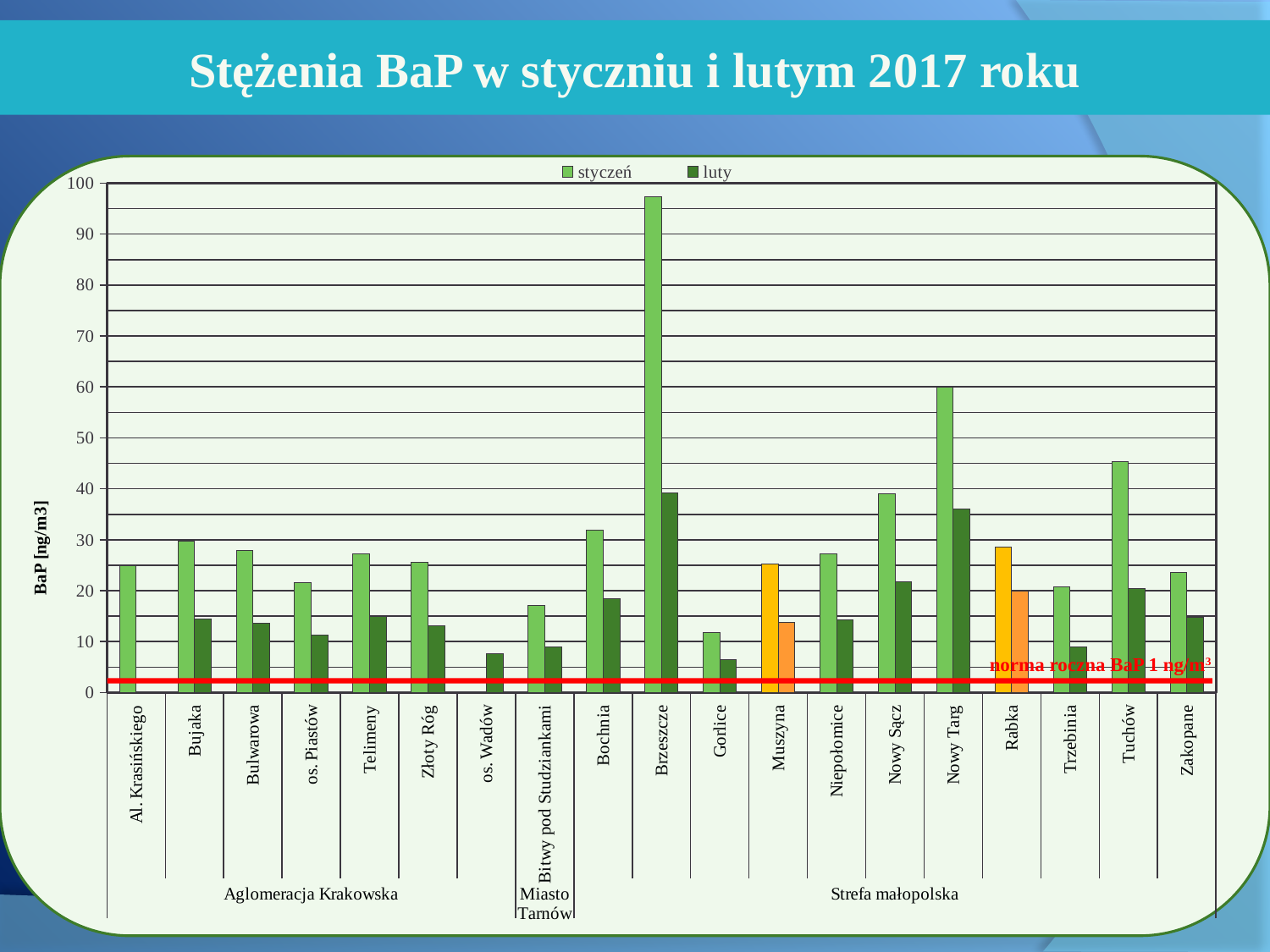
Which station has the highest styczeń (January) value? Brzeszcze Which is larger, the luty value for Nowy Targ or the luty value for Bujaka? Nowy Targ What does the red horizontal line on the chart represent? norma roczna BaP 1 ng/m³ What is the label of the y axis? BaP [ng/m3] Is the luty value for Nowy Sącz greater or less than 10? greater Is the styczeń value for Gorlice greater or less than 20? less Which is larger, the styczeń value for Brzeszcze or the styczeń value for Nowy Targ? Brzeszcze Is the styczeń value for Brzeszcze greater or less than 90? greater How many measurement stations (categories) are shown on the x axis? 19 What type of chart is shown on the slide? bar chart How many series does the legend list? 2